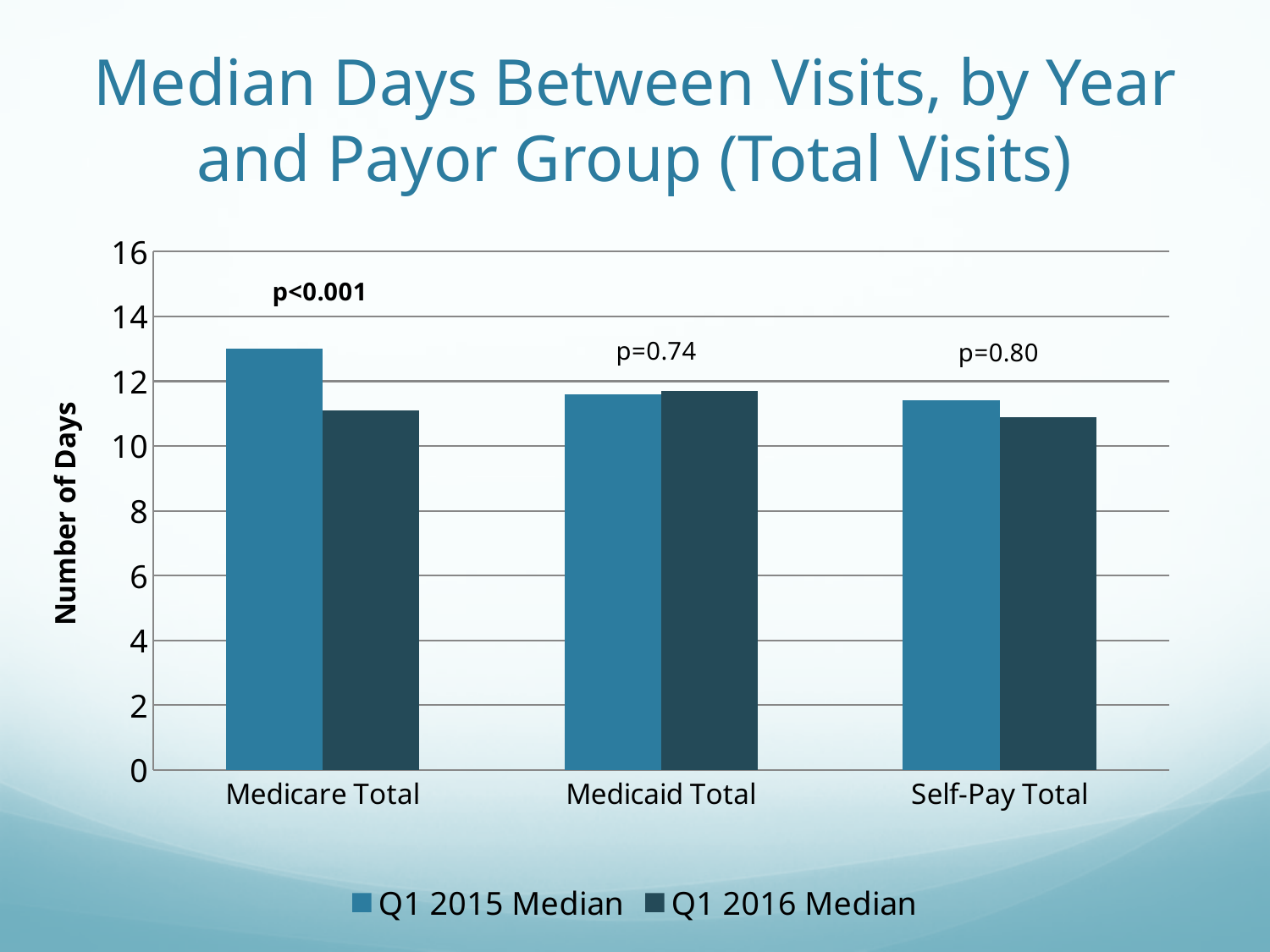
Is the Q1 2016 Median value for Self-Pay Total greater or less than 10? greater What kind of chart is shown on the slide? Bar chart For Self-Pay Total, which is larger: the Q1 2015 Median or the Q1 2016 Median? Q1 2015 Median What p-value is shown above the Medicare Total bars? p<0.001 Is the Q1 2016 Median value for Medicare Total greater or less than 12? less Which payor group has the highest Q1 2016 Median value? Medicaid Total How many payor groups are shown on the x axis? 3 How many series does the legend list? 2 Is the Q1 2015 Median value for Medicare Total greater or less than 12? greater What is the label on the y axis? Number of Days Which payor group has the highest Q1 2015 Median value? Medicare Total For Medicare Total, which is larger: the Q1 2015 Median or the Q1 2016 Median? Q1 2015 Median